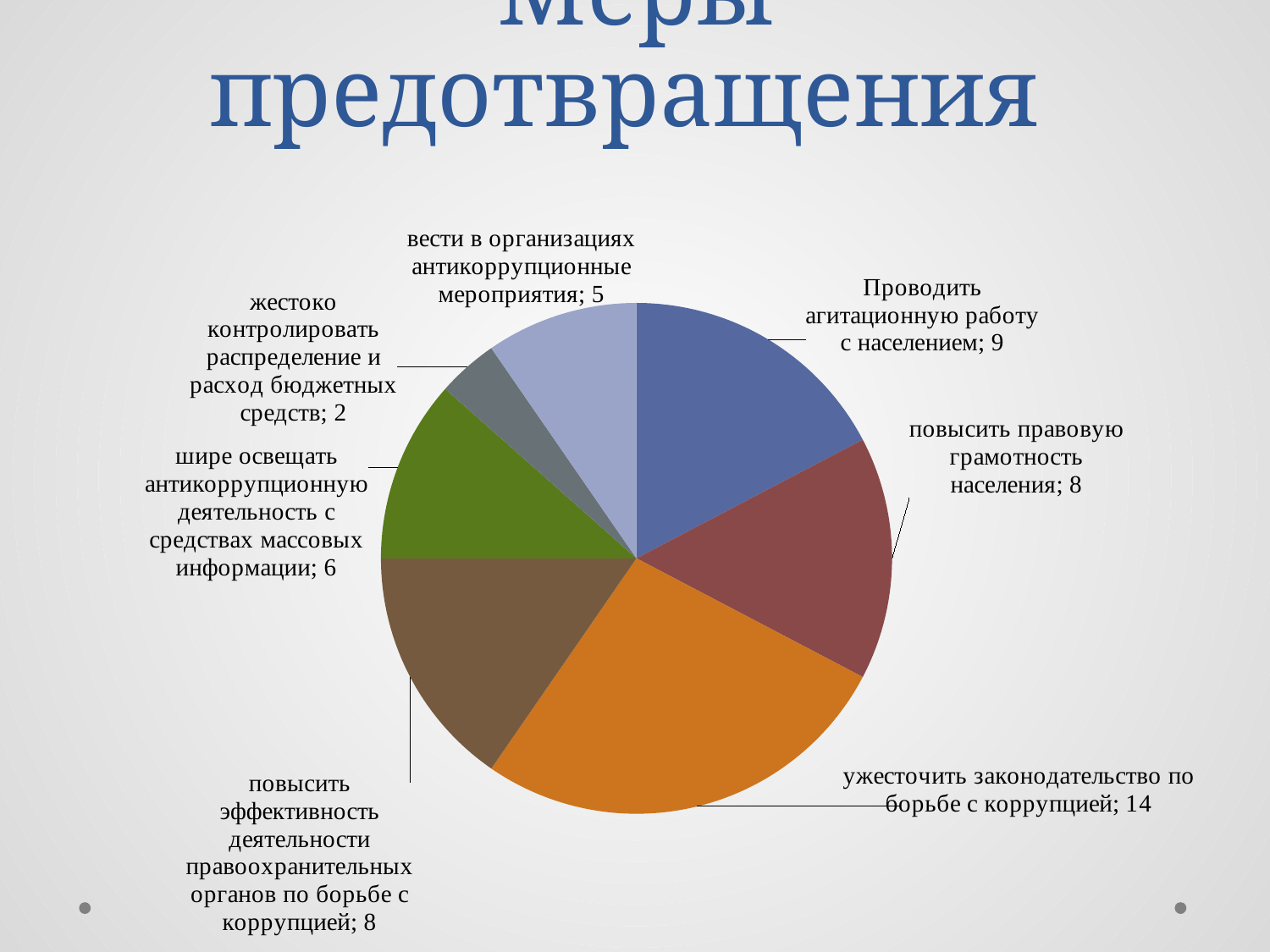
What is the difference between the value for "ужесточить законодательство по борьбе с коррупцией" and the value for "Проводить агитационную работу с населением"? 5 What is the value for "вести в организациях антикоррупционные мероприятия"? 5 Which is larger: the value for "шире освещать антикоррупционную деятельность с средствах массовых информации" or the value for "вести в организациях антикоррупционные мероприятия"? шире освещать антикоррупционную деятельность с средствах массовых информации Which category has the smallest slice of the pie? жестоко контролировать распределение и расход бюджетных средств What type of chart is shown on the slide? pie chart Which category has the largest slice of the pie? ужесточить законодательство по борьбе с коррупцией What is the value for "шире освещать антикоррупционную деятельность с средствах массовых информации"? 6 What is the value for "ужесточить законодательство по борьбе с коррупцией"? 14 What is the value for "Проводить агитационную работу с населением"? 9 How many slices does the pie chart have? 7 What colour is the slice for "ужесточить законодательство по борьбе с коррупцией"? orange What is the total of all the values shown in the pie chart? 52